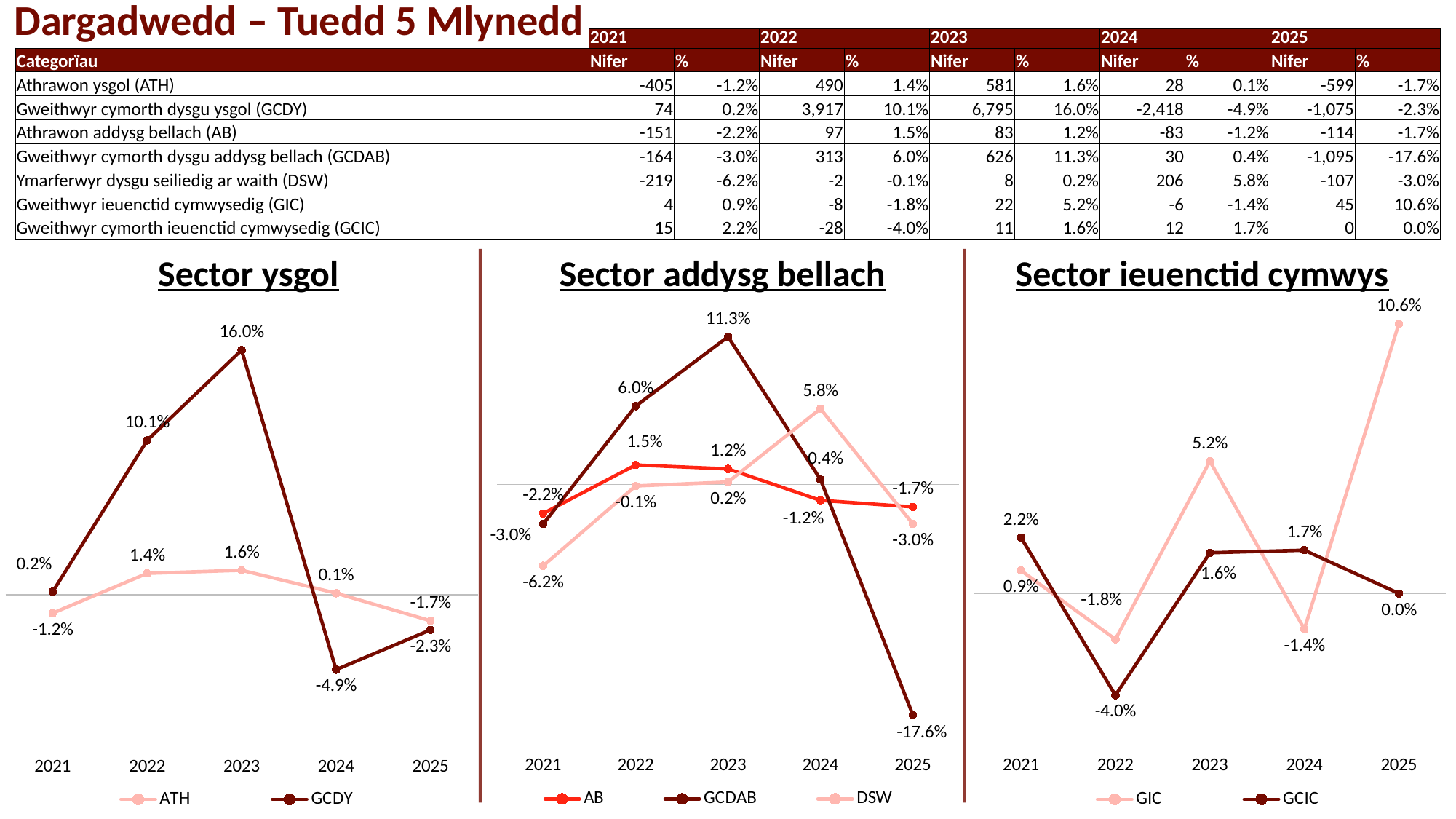
In the 'Sector addysg bellach' chart, which series has the highest value in 2024? DSW In the 'Sector addysg bellach' chart, what is the value for GCDAB in 2025? -17.6% In the 'Sector addysg bellach' chart, how many series does the legend list? 3 In the 'Sector ysgol' chart, in which year is the GCDY line at its lowest? 2024 In the 'Sector ysgol' chart, what is the difference between the GCDY and ATH values in 2022? 8.7 percentage points In the 'Sector ysgol' chart, how many series does the legend list? 2 In the 'Sector ieuenctid cymwys' chart, in which year is the GCIC line at its lowest? 2022 In the 'Sector ieuenctid cymwys' chart, what is the value for GIC in 2025? 10.6% In the 'Sector addysg bellach' chart, which is larger in 2021: the AB value or the DSW value? AB In the 'Sector ieuenctid cymwys' chart, how many years are shown on the x axis? 5 What kind of chart is the 'Sector ysgol' chart? Line chart In the 'Sector ysgol' chart, what is the value for GCDY in 2023? 16.0%